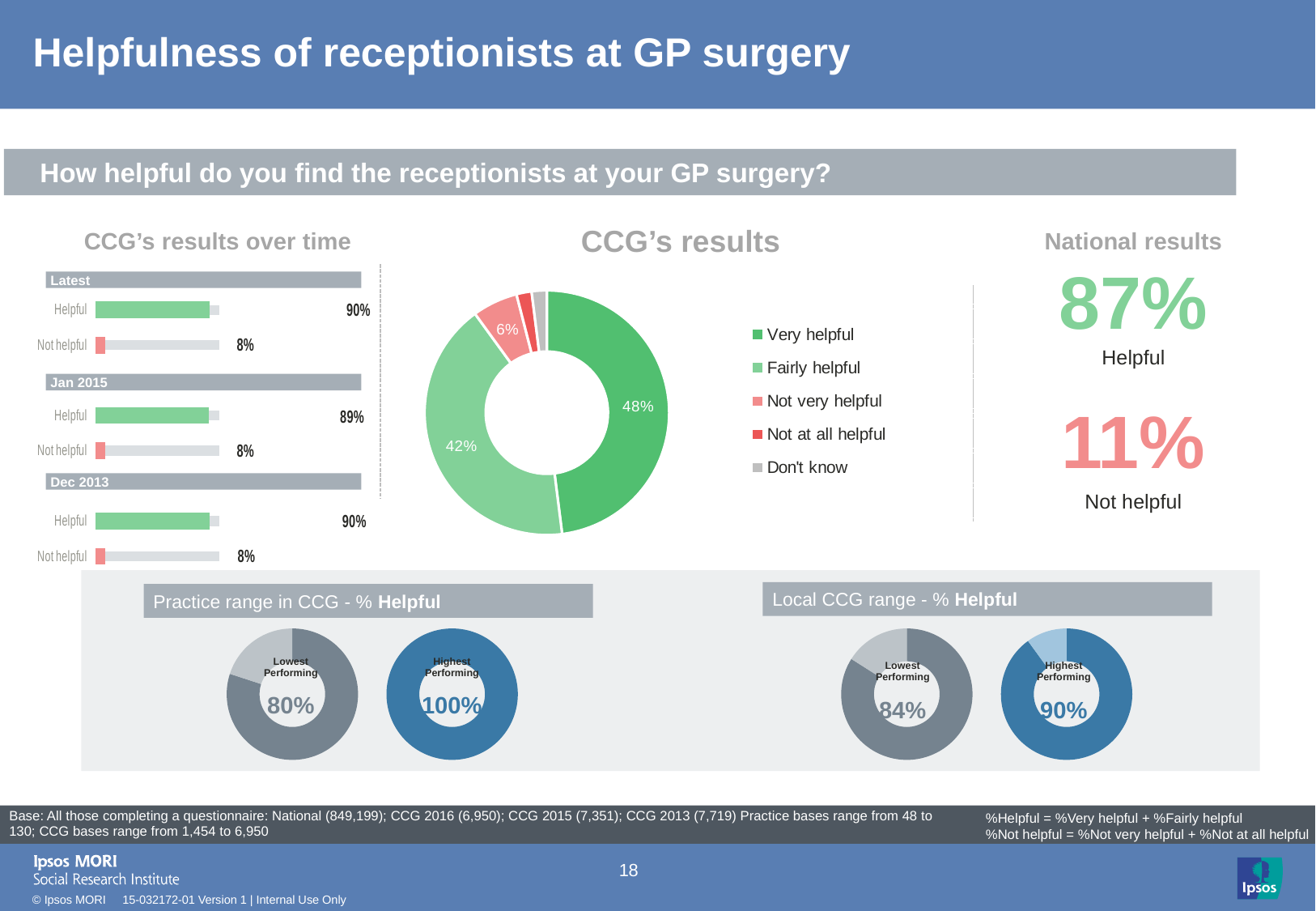
In the 'CCG's results over time' chart, what is the Helpful value for Jan 2015? 89% In the 'CCG's results' donut chart, what percentage is shown for Very helpful? 48% How many entries does the legend of the 'CCG's results' donut chart list? 5 In the 'Practice range in CCG - % Helpful' section, what is the Highest Performing value? 100% In the 'CCG's results over time' chart, what is the Not helpful value for Dec 2013? 8% In the 'CCG's results over time' chart, what is the difference between the Helpful and Not helpful values for Latest? 82 percentage points In the 'CCG's results' donut chart, what percentage is shown for Not very helpful? 6% What type of chart is used for 'CCG's results'? Donut (pie) chart What type of chart is 'CCG's results over time'? Bar chart In the 'CCG's results' donut chart, which category has the largest share? Very helpful In the 'CCG's results' donut chart, what percentage is shown for Fairly helpful? 42% In the 'Local CCG range - % Helpful' section, what is the Lowest Performing value? 84%